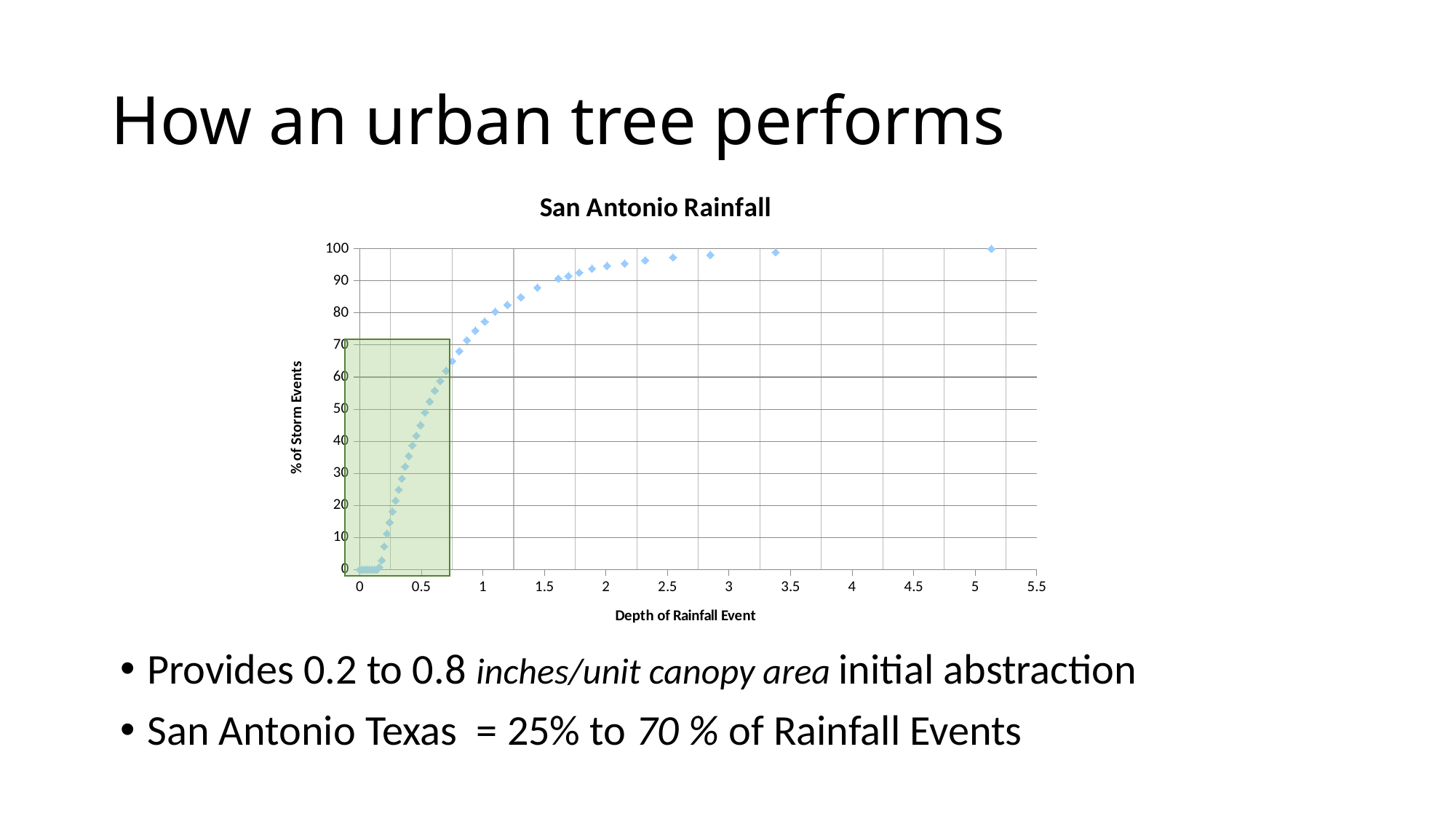
Is the % of Storm Events at a rainfall depth of 1.5 greater or less than 80? greater Is the % of Storm Events at a rainfall depth of 2 greater or less than 90? greater What is the title of the chart? San Antonio Rainfall Is the % of Storm Events at a rainfall depth of 3 greater or less than 90? greater What is the label of the vertical axis of the chart? % of Storm Events What kind of chart is shown on the slide? scatter chart Do the plotted values rise or fall as Depth of Rainfall Event increases? rise What is the highest value shown on the horizontal axis of the chart? 5.5